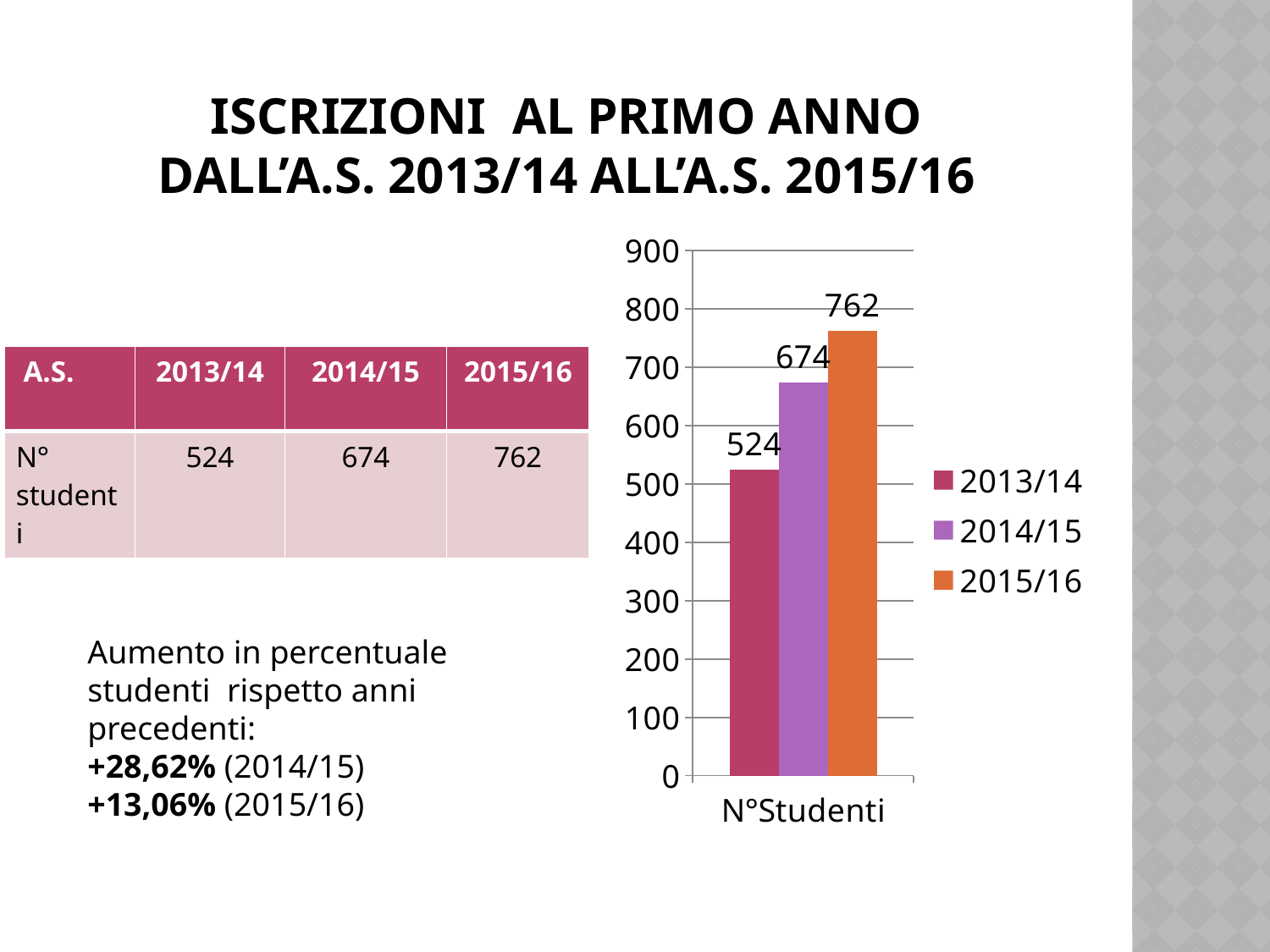
Which is larger, the value for 2014/15 or the value for 2015/16? 2015/16 What is the difference between the values for 2015/16 and 2013/14? 238 What kind of chart is shown on the slide? bar chart What is the value for 2013/14 in the chart? 524 What is the category label shown on the x axis of the chart? N°Studenti What is the difference between the values for 2014/15 and 2013/14? 150 Is the value for 2013/14 greater or less than 600? less Which series has the lowest value in the chart? 2013/14 What is the value for 2014/15 in the chart? 674 Which series has the highest value in the chart? 2015/16 What is the value for 2015/16 in the chart? 762 How many series does the legend list? 3